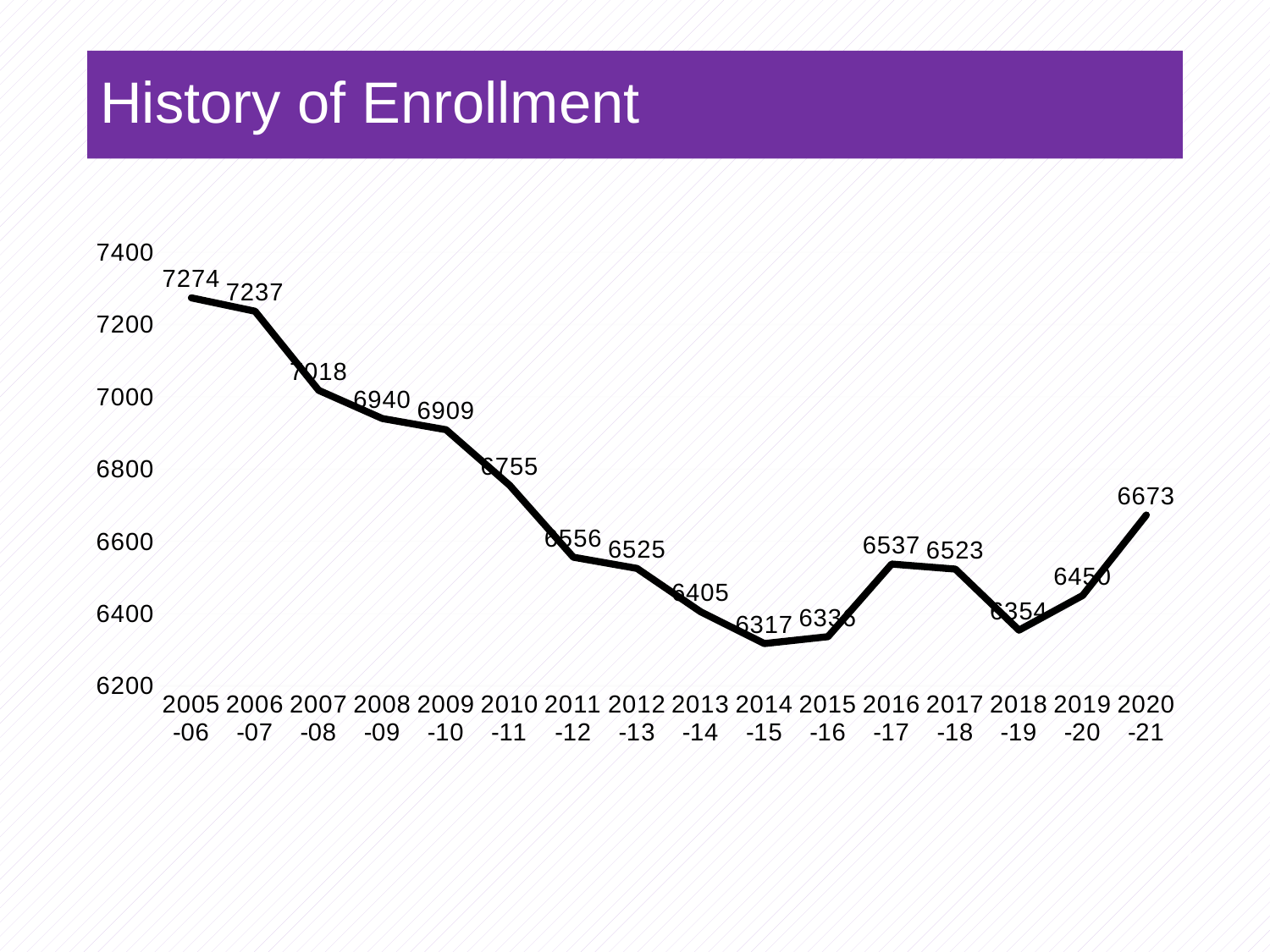
What was the enrollment in 2016-17? 6537 Which year had higher enrollment, 2009-10 or 2019-20? 2009-10 Which year had the highest enrollment? 2005-06 What is the difference in enrollment between 2016-17 and 2017-18? 14 What was the enrollment in 2005-06? 7274 What was the enrollment in 2014-15? 6317 What kind of chart is shown on the slide? line chart What is the difference in enrollment between 2005-06 and 2020-21? 601 What was the enrollment in 2020-21? 6673 Which year had the lowest enrollment? 2014-15 How many school years are plotted on the chart? 16 Is the enrollment value for 2015-16 greater or less than 6400? less